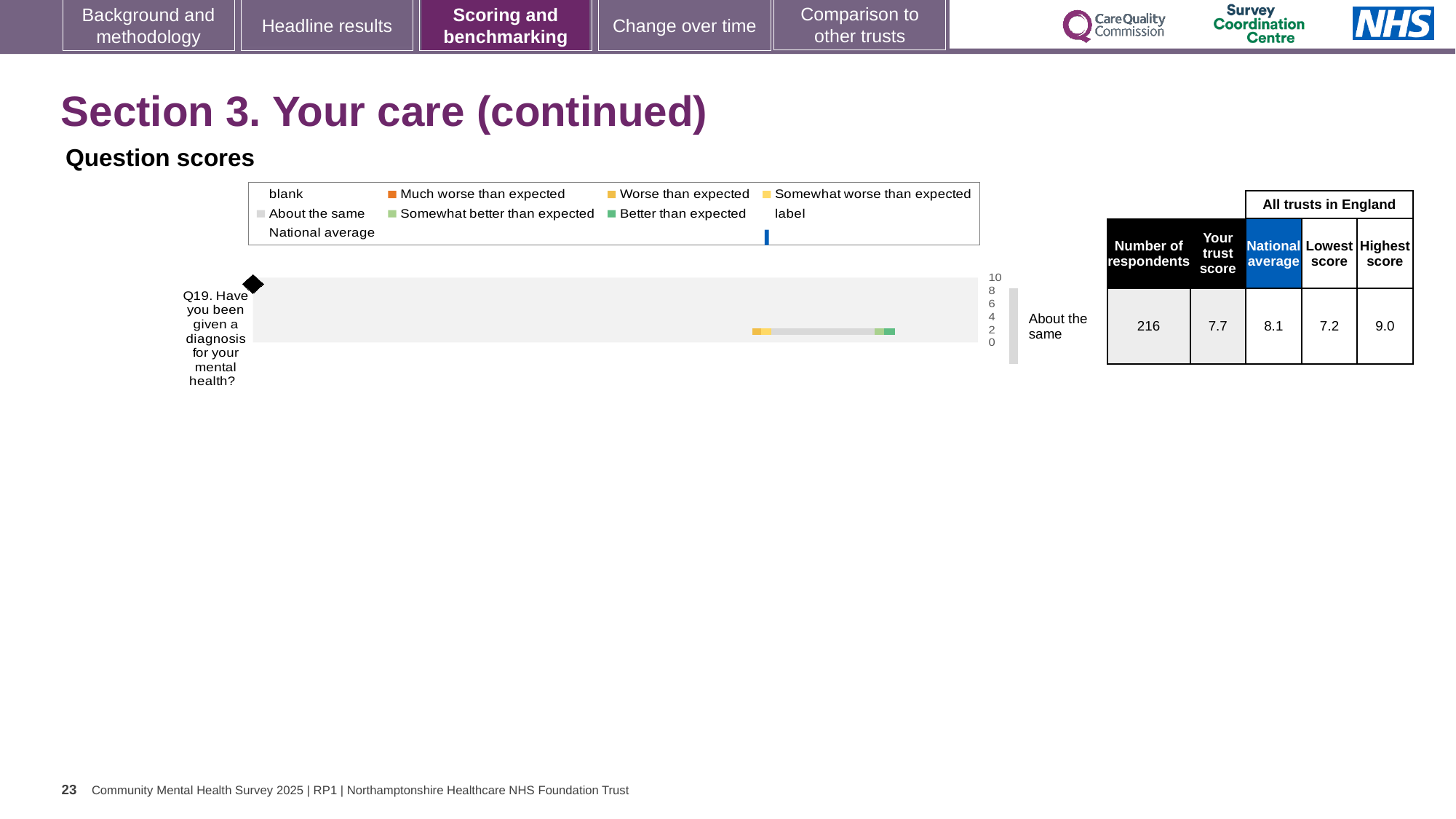
Which survey question is plotted on the question scores chart? Q19. Have you been given a diagnosis for your mental health? What is the trust's score for Q19? 7.7 What benchmark category is shown next to the bar for Q19? About the same What is the lowest score among all trusts in England for Q19? 7.2 What is the national average score for Q19? 8.1 Which is larger for Q19, the trust's score or the national average? national average What is the difference between the highest and lowest trust scores for Q19? 1.8 Is the trust's score for Q19 greater or less than 8? less What is the number of respondents for Q19? 216 What kind of chart is used to show the question scores? bar chart What is the highest score among all trusts in England for Q19? 9.0 How many survey questions are plotted on the question scores chart? 1